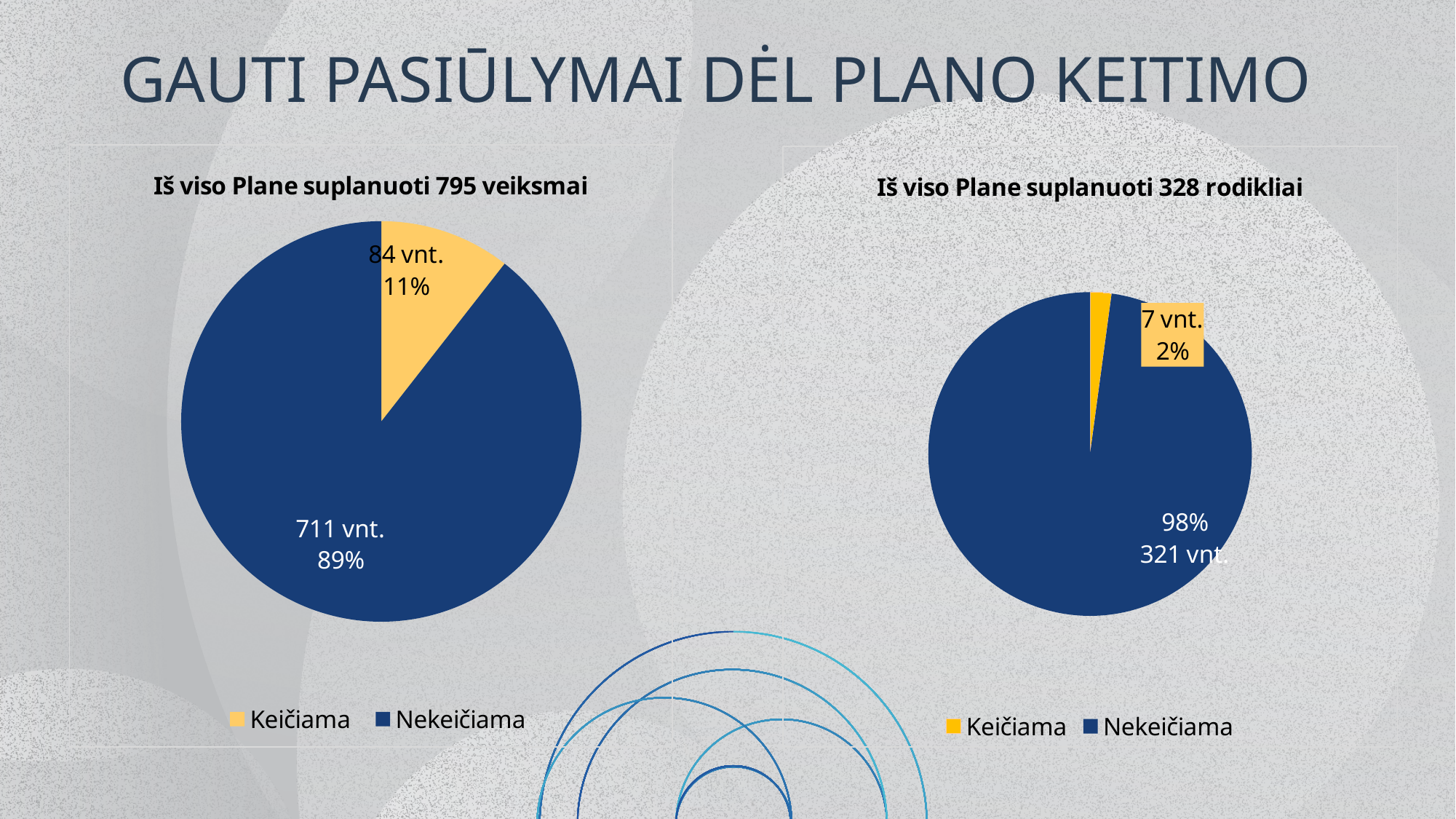
In the right chart titled 'Iš viso Plane suplanuoti 328 rodikliai', how many units are labelled for Nekeičiama? 321 vnt. In the left chart titled 'Iš viso Plane suplanuoti 795 veiksmai', how many units are labelled for Nekeičiama? 711 vnt. What type of chart is the left chart titled 'Iš viso Plane suplanuoti 795 veiksmai'? Pie chart In the left chart titled 'Iš viso Plane suplanuoti 795 veiksmai', what is the difference in units between Nekeičiama and Keičiama? 627 vnt. In the left chart titled 'Iš viso Plane suplanuoti 795 veiksmai', what percentage share does Nekeičiama have? 89% How many entries does the legend of the right chart titled 'Iš viso Plane suplanuoti 328 rodikliai' list? 2 In the right chart titled 'Iš viso Plane suplanuoti 328 rodikliai', what is the difference in units between Nekeičiama and Keičiama? 314 vnt. In the right chart titled 'Iš viso Plane suplanuoti 328 rodikliai', what percentage share does Keičiama have? 2% In the right chart titled 'Iš viso Plane suplanuoti 328 rodikliai', how many units are labelled for Keičiama? 7 vnt. In the left chart titled 'Iš viso Plane suplanuoti 795 veiksmai', how many units are labelled for Keičiama? 84 vnt. In the right chart titled 'Iš viso Plane suplanuoti 328 rodikliai', which category has the smallest slice? Keičiama In the left chart titled 'Iš viso Plane suplanuoti 795 veiksmai', which category has the largest slice? Nekeičiama